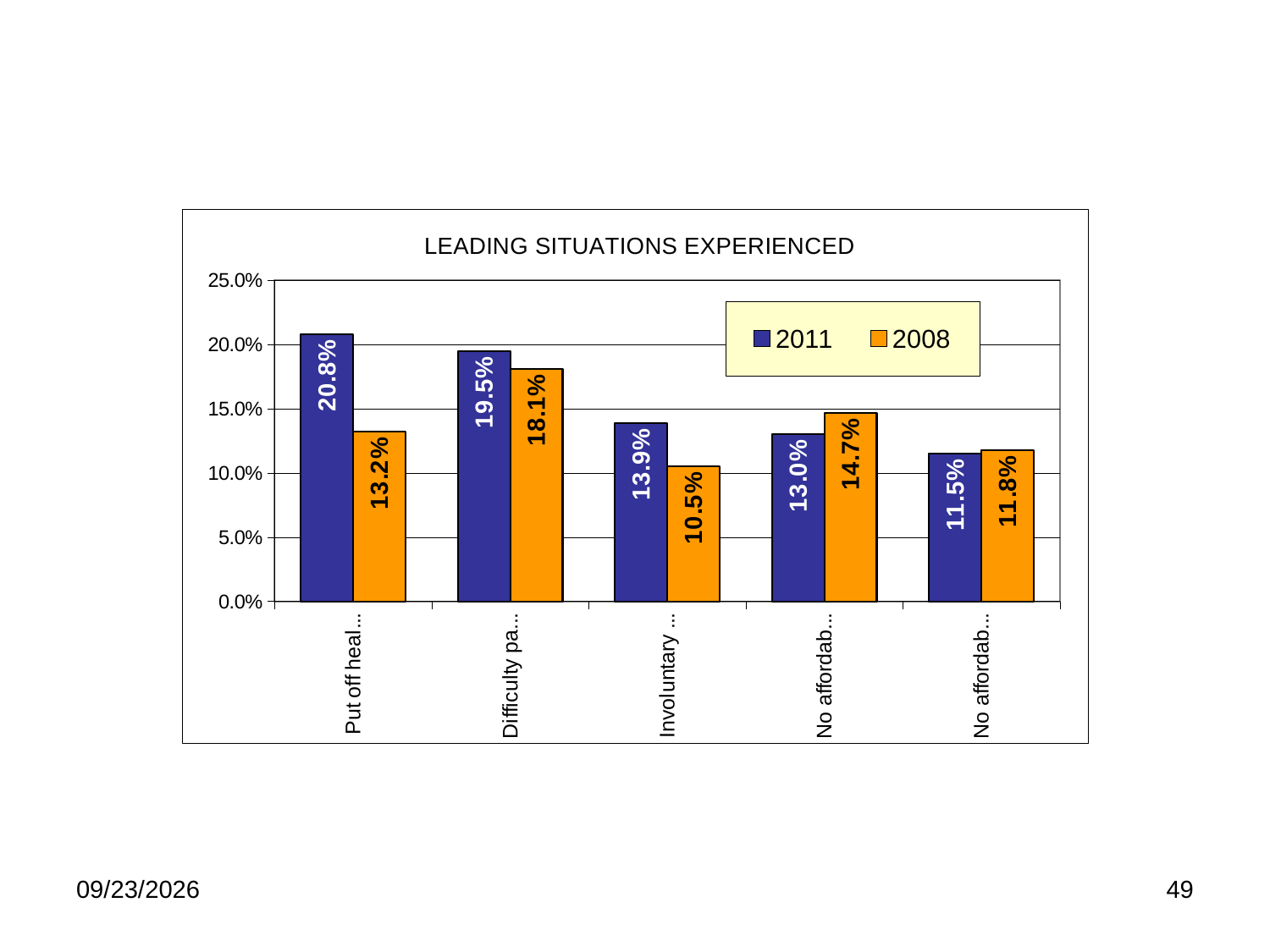
For the category "Involuntary ...", which year has the larger value, 2011 or 2008? 2011 What is the 2008 value for the category "Involuntary ..."? 10.5% What is the 2008 value for the fourth category from the left? 14.7% Which category has the lowest 2008 value? Involuntary ... For the first category, "Put off heal...", how much higher is the 2011 value than the 2008 value? 7.6 percentage points What is the 2008 value for the category "Difficulty pa..."? 18.1% How many series does the legend list? 2 Which category has the highest 2011 value? Put off heal... (the first category) What is the 2011 value for the first category, "Put off heal..."? 20.8% What kind of chart is shown on the slide? Bar chart What is the title of the chart? LEADING SITUATIONS EXPERIENCED How many categories are shown on the x axis? 5